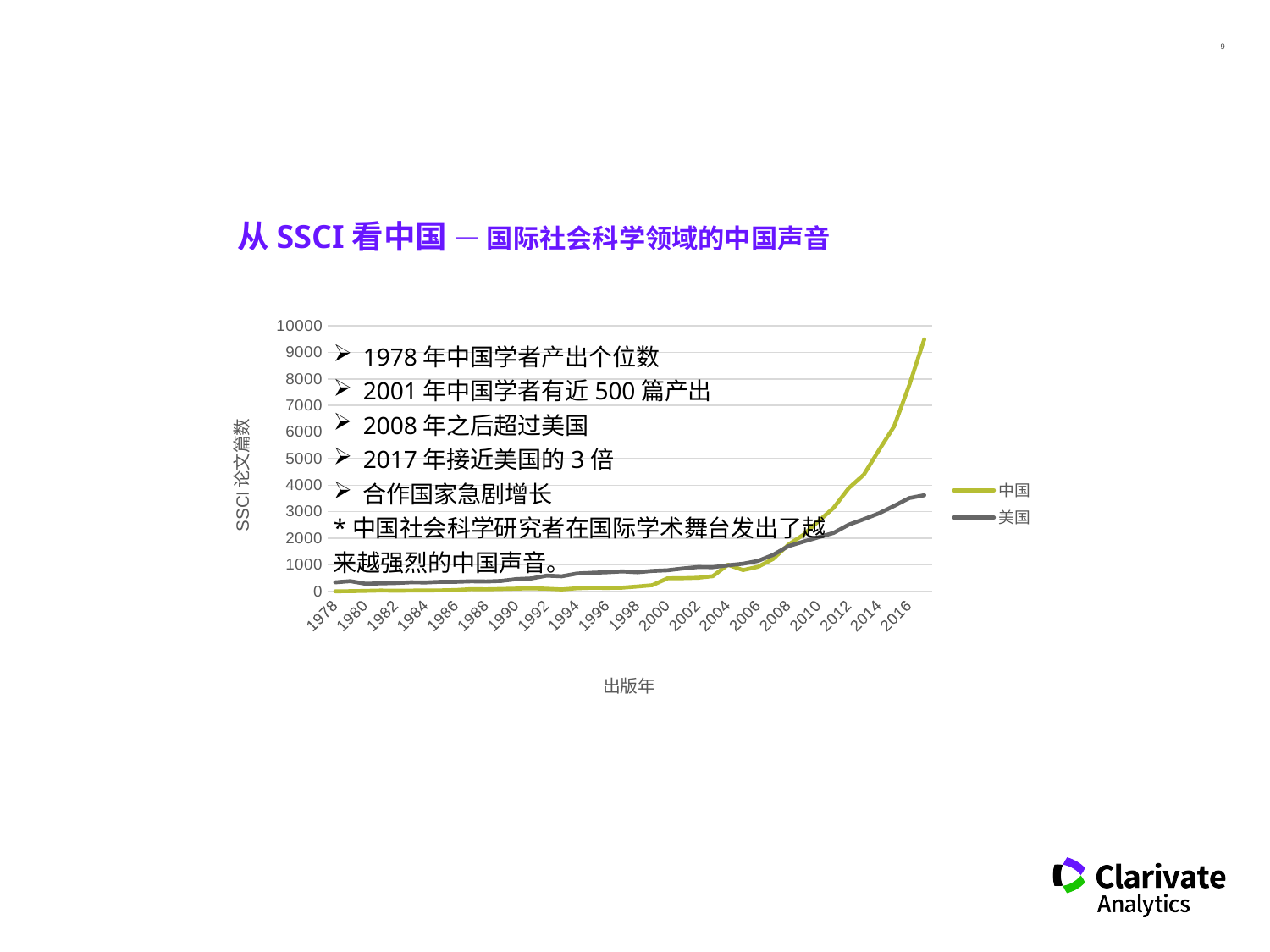
Is the value for 中国 in 1990 greater or less than 1000? less Is the value for 中国 in 2016 greater or less than 6000? greater Is the value for 美国 at the final year (2017) greater or less than 4000? less Does the 中国 series rise or fall overall from 1978 to 2017? rise Which series has the higher value in 2016, 中国 or 美国? 中国 How many series does the chart's legend list? 2 What is the title of the chart's vertical axis? SSCI 论文篇数 Which series has the higher value in 2000, 中国 or 美国? 美国 What kind of chart is shown on the slide? line chart What are the two series named in the chart's legend? 中国, 美国